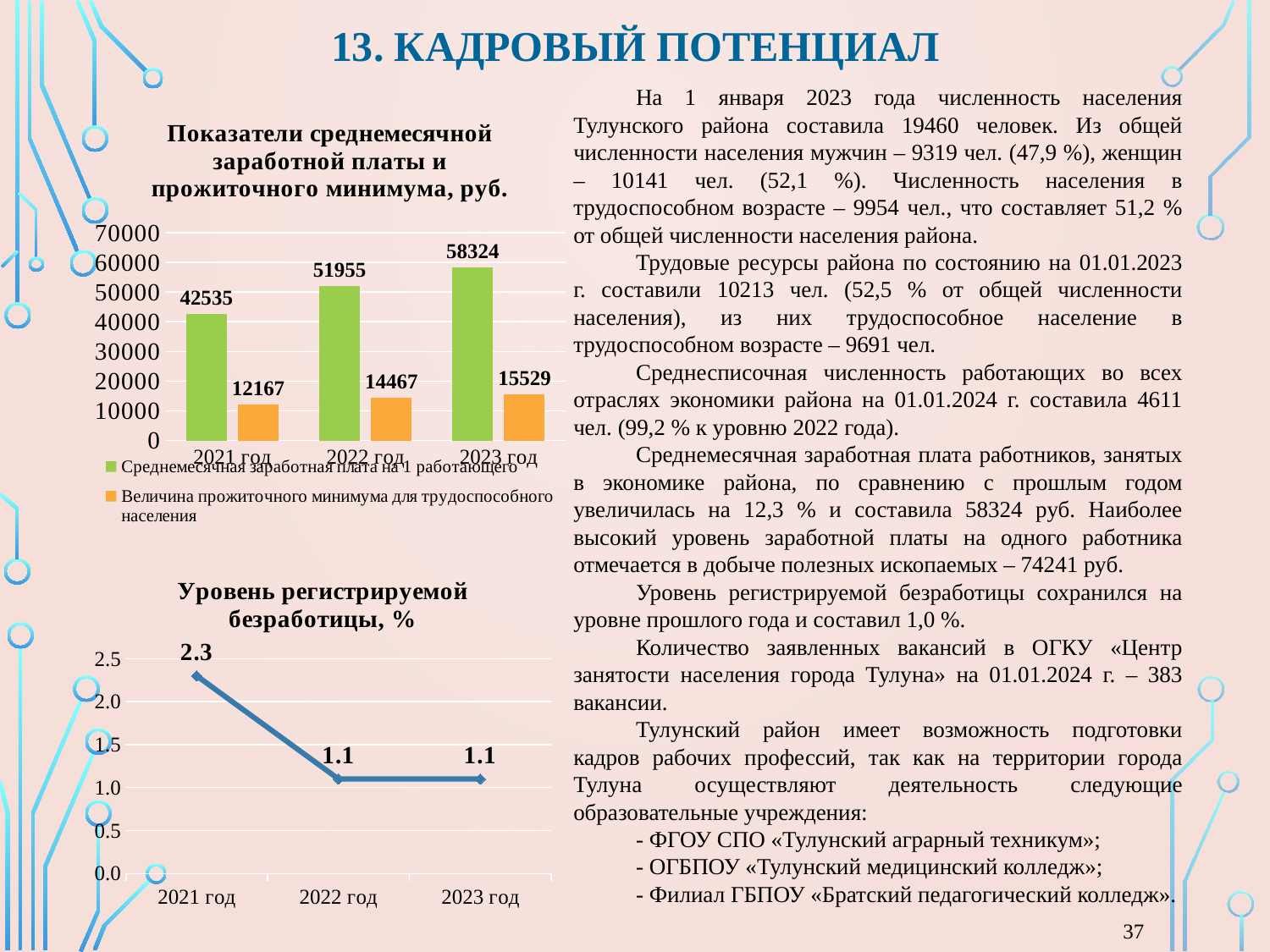
In the chart 'Показатели среднемесячной заработной платы и прожиточного минимума, руб.', how many series does the legend list? 2 In the chart 'Уровень регистрируемой безработицы, %', how many data points are plotted? 3 In the chart 'Показатели среднемесячной заработной платы и прожиточного минимума, руб.', what is the value of 'Величина прожиточного минимума для трудоспособного населения' for 2021 год? 12167 What kind of chart is 'Уровень регистрируемой безработицы, %'? line chart In the chart 'Показатели среднемесячной заработной платы и прожиточного минимума, руб.', what is the average monthly wage (Среднемесячная заработная плата на 1 работающего) for 2023 год? 58324 In the chart 'Показатели среднемесячной заработной платы и прожиточного минимума, руб.', in which year is the average monthly wage the lowest? 2021 год In the chart 'Показатели среднемесячной заработной платы и прожиточного минимума, руб.', what is the difference between the average monthly wage in 2023 год and in 2022 год? 6369 In the chart 'Уровень регистрируемой безработицы, %', what is the value for 2021 год? 2.3 What kind of chart is 'Показатели среднемесячной заработной платы и прожиточного минимума, руб.'? bar chart In the chart 'Уровень регистрируемой безработицы, %', what is the difference between the values for 2021 год and 2022 год? 1.2 In the chart 'Показатели среднемесячной заработной платы и прожиточного минимума, руб.', does the average monthly wage rise or fall from 2021 год to 2023 год? rise In the chart 'Показатели среднемесячной заработной платы и прожиточного минимума, руб.', which colour represents 'Величина прожиточного минимума для трудоспособного населения'? orange